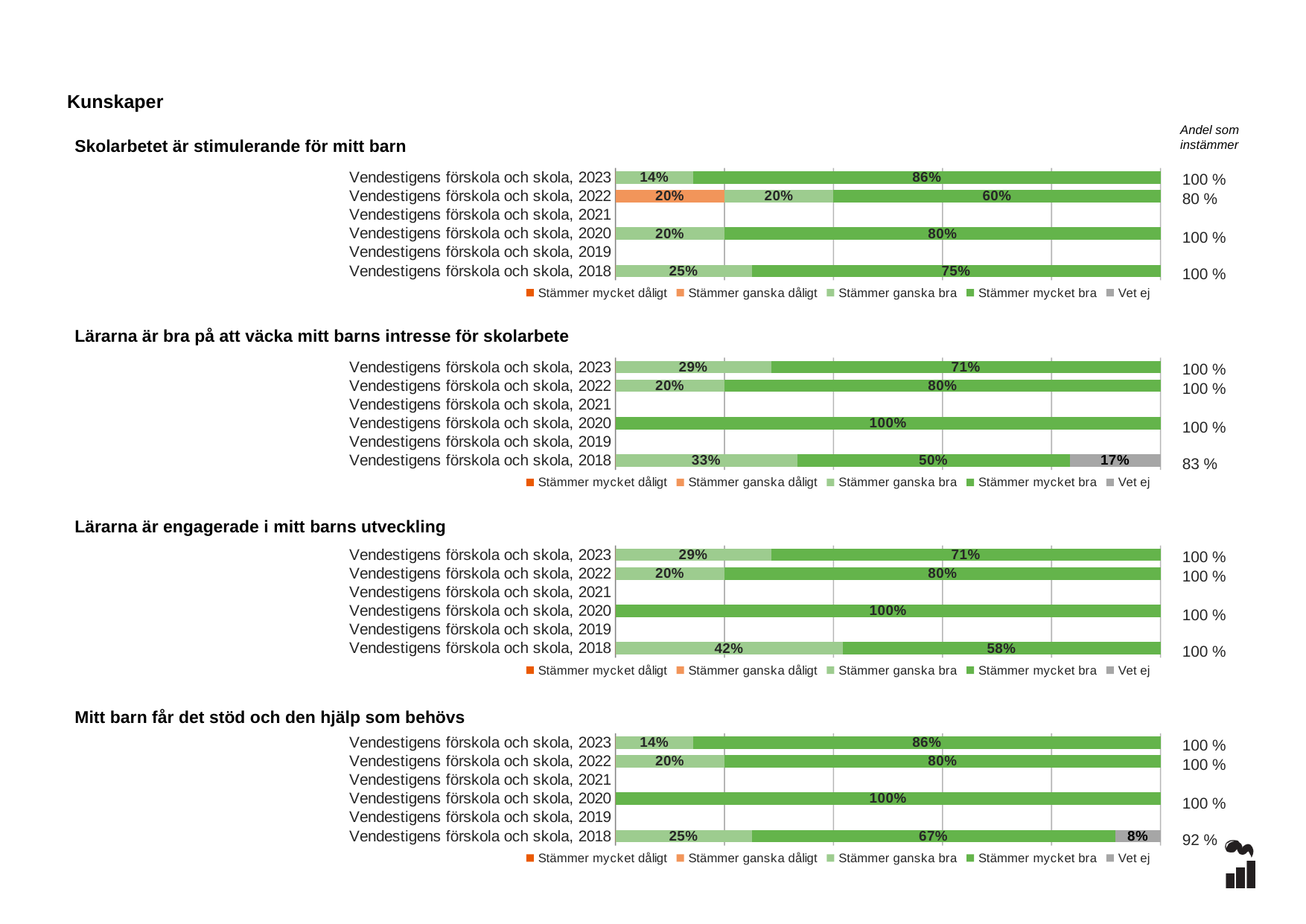
In the chart 'Skolarbetet är stimulerande för mitt barn', what is the value of 'Stämmer mycket bra' for Vendestigens förskola och skola, 2023? 86% In the chart 'Mitt barn får det stöd och den hjälp som behövs', what is the 'Andel som instämmer' value for Vendestigens förskola och skola, 2018? 92 % How many series does the legend list in the chart 'Skolarbetet är stimulerande för mitt barn'? 5 What kind of chart is 'Mitt barn får det stöd och den hjälp som behövs'? Stacked bar chart In the chart 'Mitt barn får det stöd och den hjälp som behövs', what is the difference between the 'Stämmer mycket bra' values for 2023 and 2018? 19% How many category rows are shown in the chart 'Lärarna är engagerade i mitt barns utveckling'? 6 In the chart 'Lärarna är engagerade i mitt barns utveckling', what is the value of 'Stämmer ganska bra' for Vendestigens förskola och skola, 2018? 42% In the chart 'Skolarbetet är stimulerande för mitt barn', which year has the lowest 'Stämmer mycket bra' value among the years with data? 2022 In the chart 'Lärarna är bra på att väcka mitt barns intresse för skolarbete', is the 'Stämmer ganska bra' value larger for 2023 or for 2022? 2023 In the chart 'Skolarbetet är stimulerande för mitt barn', what is the value of 'Stämmer ganska dåligt' for Vendestigens förskola och skola, 2022? 20% In the chart 'Lärarna är engagerade i mitt barns utveckling', which year has the highest 'Stämmer mycket bra' value? 2020 In the chart 'Lärarna är bra på att väcka mitt barns intresse för skolarbete', what is the value of 'Vet ej' for Vendestigens förskola och skola, 2018? 17%